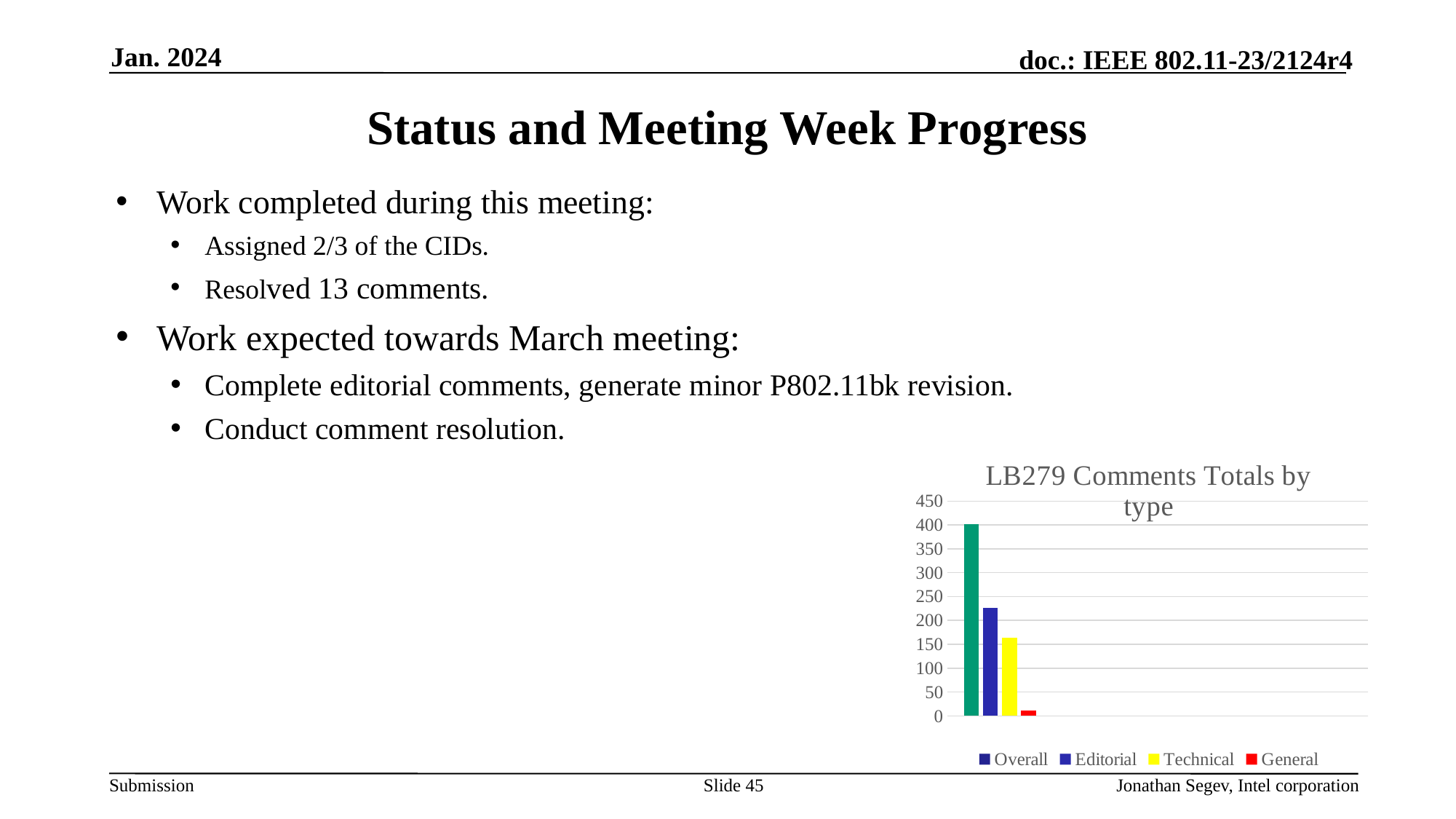
Which series is shown in red in the chart? General Which is larger, the value for Editorial or the value for Technical? Editorial Which series has the lowest value in the chart? General Is the value for Editorial greater or less than 200? greater Is the value for Technical greater or less than 100? greater What is the title of the chart? LB279 Comments Totals by type Is the value for General greater or less than 50? less How many series does the chart legend list? 4 What kind of chart is shown on the slide? bar chart Which series has the highest value in the chart? Overall